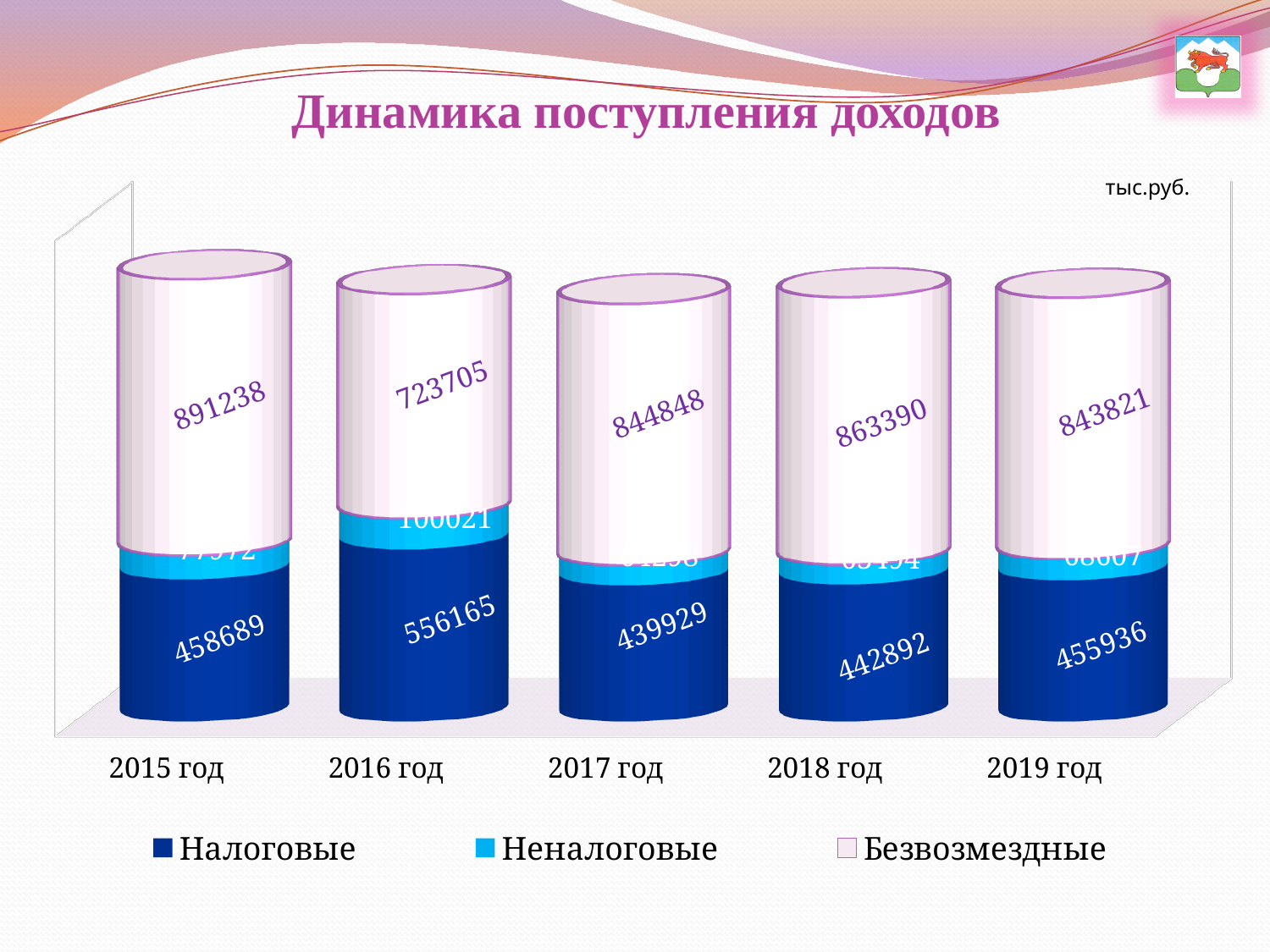
In which year is the Безвозмездные value the lowest? 2016 год How many years (categories) are shown on the x axis? 5 How many series does the legend list? 3 Which year has the larger Безвозмездные value, 2017 год or 2018 год? 2018 год What is the value of Налоговые for 2016 год? 556165 In which year is the Налоговые value the lowest? 2017 год What kind of chart is shown on the slide? Stacked bar chart What is the value of Безвозмездные for 2015 год? 891238 In which year is the Налоговые value the highest? 2016 год What is the value of Налоговые for 2019 год? 455936 What unit of measurement is indicated on the chart? тыс.руб. By how much does the Налоговые value for 2016 год exceed that for 2015 год? 97476